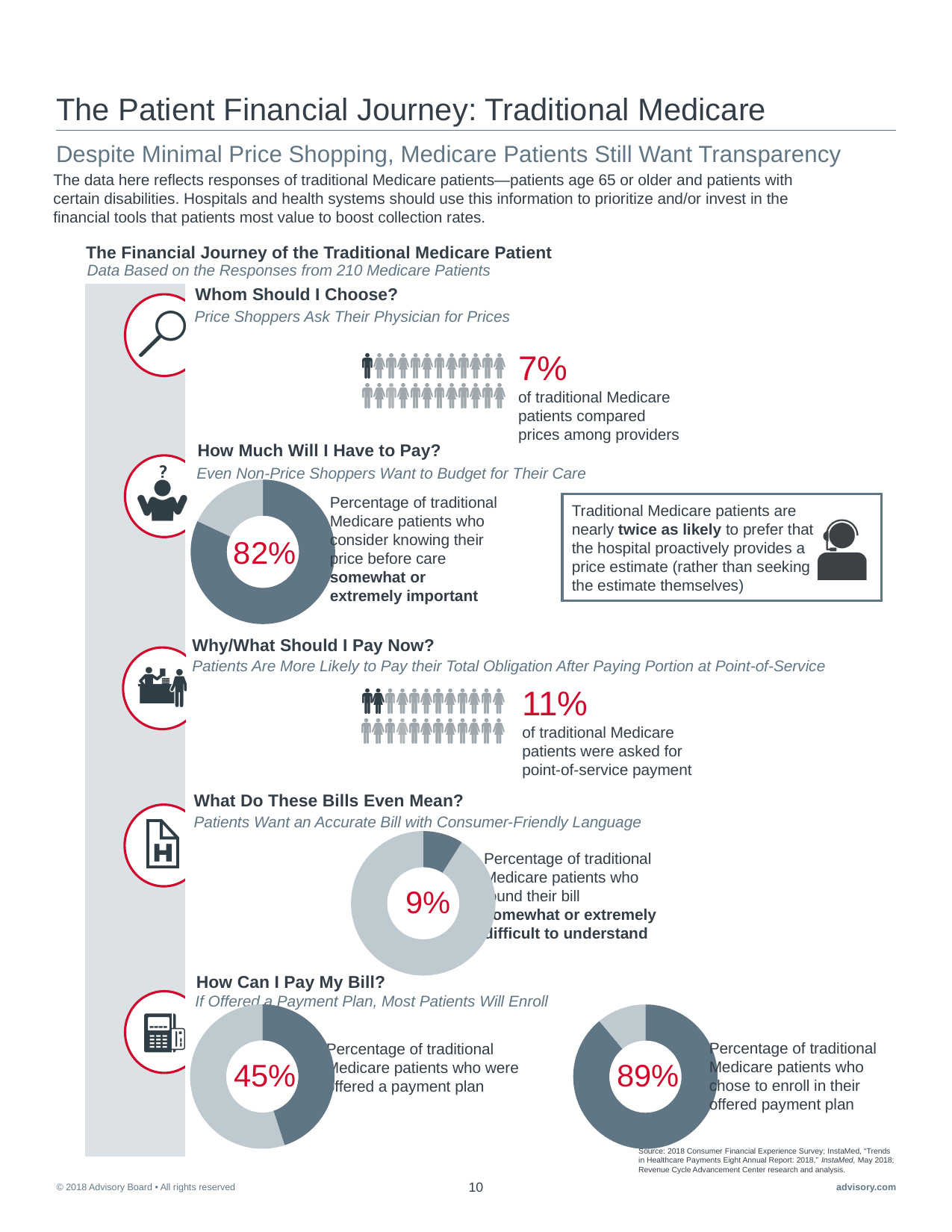
Under "How Can I Pay My Bill?", what is the difference between the percentage who chose to enroll in their offered payment plan and the percentage who were offered a payment plan? 44 percentage points In the donut chart under "How Much Will I Have to Pay?", what percentage of traditional Medicare patients consider knowing their price before care somewhat or extremely important? 82% In the left donut chart under "How Can I Pay My Bill?", what percentage of traditional Medicare patients were offered a payment plan? 45% Among the four donut charts on the slide, which one shows the highest percentage? The chart for patients who chose to enroll in their offered payment plan (89%) In the pictogram under "Whom Should I Choose?", what percentage of traditional Medicare patients compared prices among providers? 7% What kind of chart is used to show the 82% value under "How Much Will I Have to Pay?"? Donut chart In the right donut chart under "How Can I Pay My Bill?", what percentage of traditional Medicare patients chose to enroll in their offered payment plan? 89% How many donut charts are shown on the slide? 4 In the pictogram under "Why/What Should I Pay Now?", what percentage of traditional Medicare patients were asked for point-of-service payment? 11% In the donut chart under "What Do These Bills Even Mean?", what percentage of traditional Medicare patients found their bill somewhat or extremely difficult to understand? 9% Under "How Can I Pay My Bill?", which is larger: the percentage offered a payment plan or the percentage who chose to enroll in their offered payment plan? The percentage who chose to enroll (89%) Among the four donut charts on the slide, which one shows the lowest percentage? The chart for patients who found their bill somewhat or extremely difficult to understand (9%)